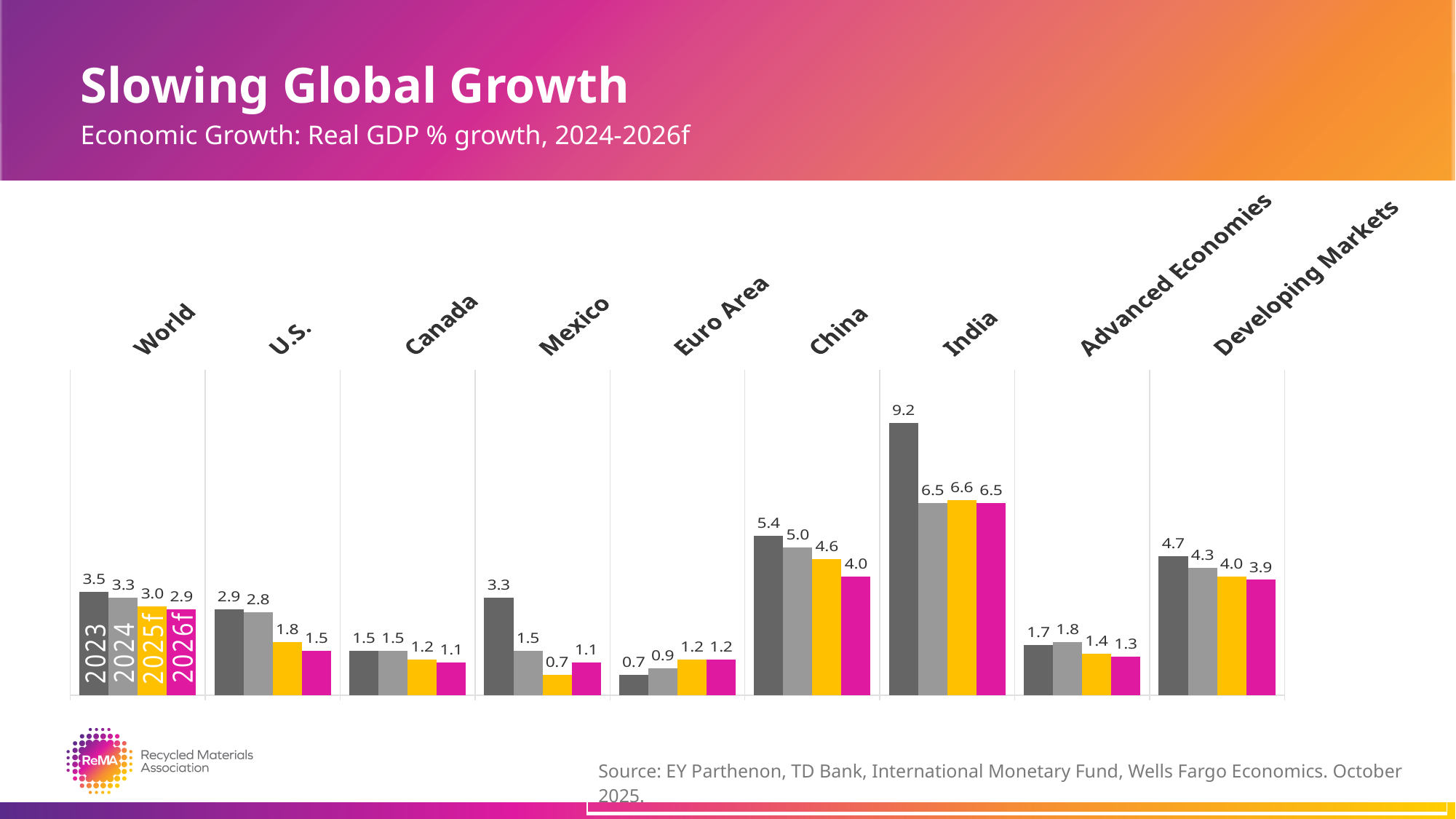
Which category has the highest 2023 value? India How many series (years) are plotted for each category? 4 How many categories (regions/countries) are shown on the chart? 9 Which is larger, the 2026f value for Advanced Economies or the 2026f value for Developing Markets? Developing Markets What is the difference between China's 2023 value and its 2026f value? 1.4 What is the 2026f value for the U.S.? 1.5 What is the 2025f value for Mexico? 0.7 What is the 2023 real GDP growth value for India? 9.2 Which category has the lowest 2023 value? Euro Area Do the values for the World rise or fall from 2023 to 2026f? Fall What kind of chart is shown on the slide? Bar chart Which is larger, the 2024 value for Canada or the 2024 value for Mexico? They are equal (1.5)